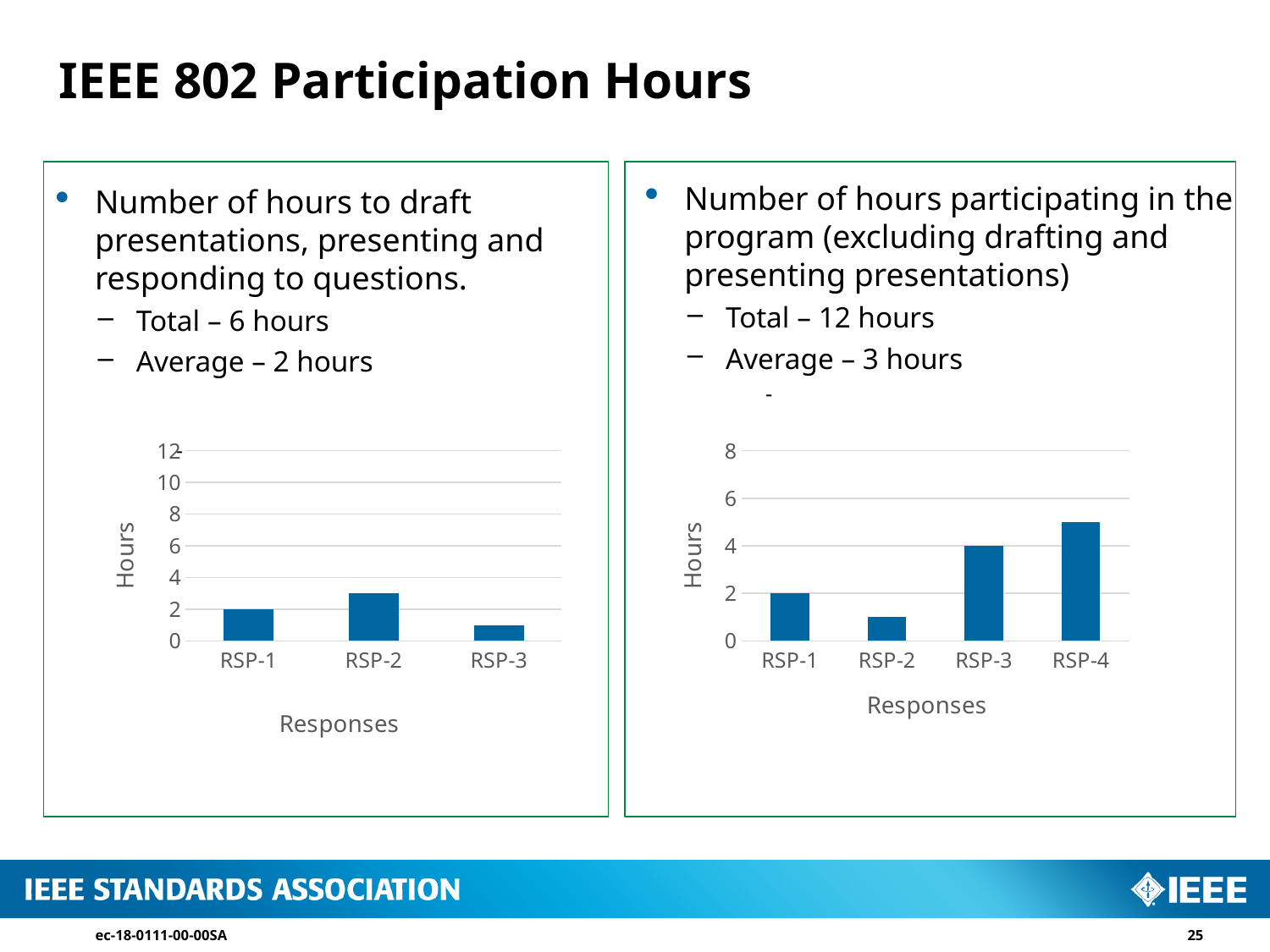
In the left chart, is the value for RSP-3 greater or less than 2? less What is the y-axis title of the right chart? Hours In the right chart, is the value for RSP-4 greater or less than 4? greater In the right chart, what is the value for RSP-3? 4 In the right chart, which response has the lowest number of hours? RSP-2 In the right chart, what is the difference between the values for RSP-3 and RSP-1? 2 In the left chart, what is the value for RSP-1? 2 In the left chart, which response has the highest number of hours? RSP-2 What type of chart is the left chart? Bar chart In the left chart, which response has the lowest number of hours? RSP-3 How many responses are shown in the right chart? 4 In the right chart, which response has the highest number of hours? RSP-4